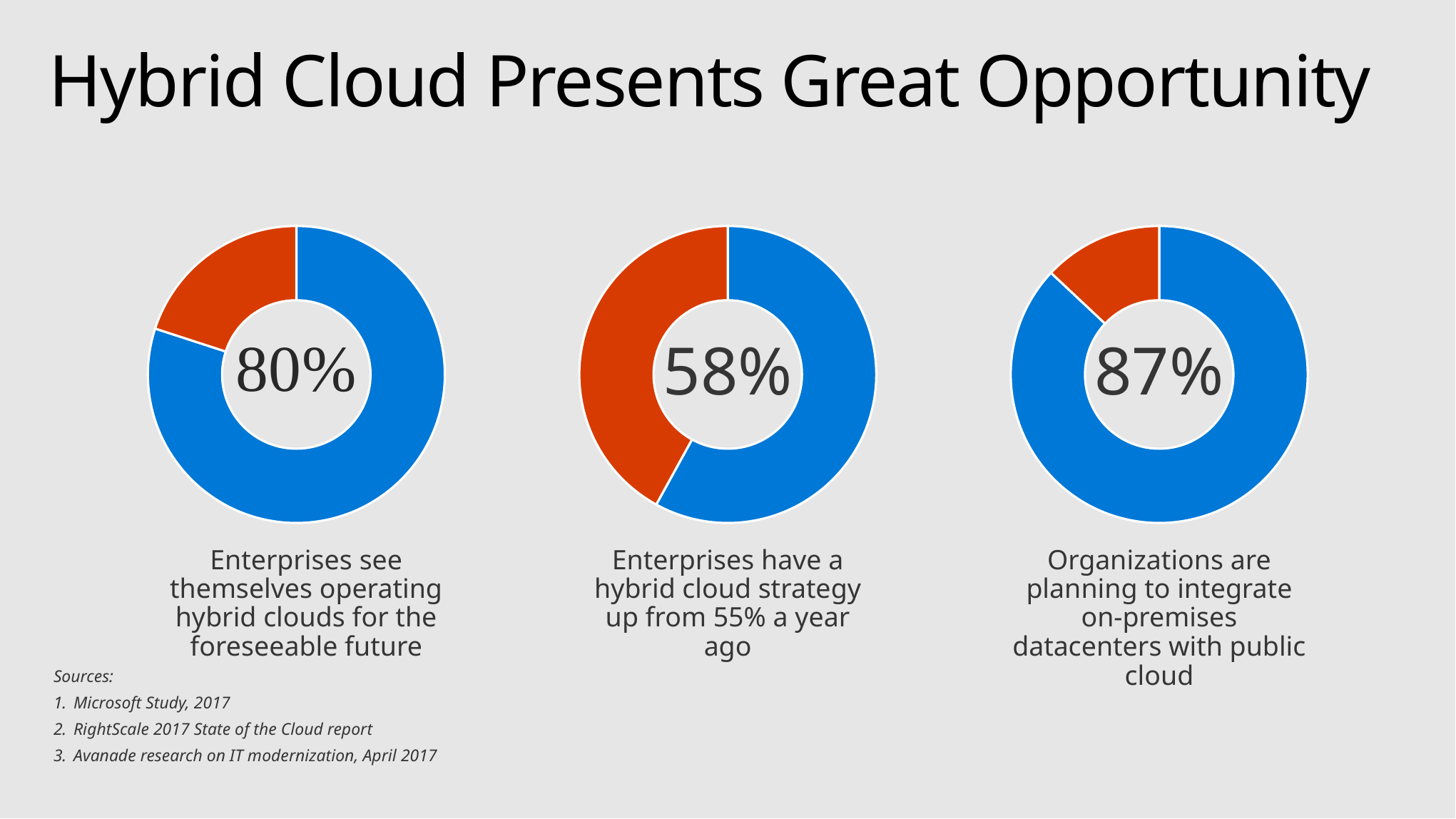
What is the difference between the percentage in the right donut chart and the percentage in the left donut chart? 7% What value is shown in the center of the left donut chart? 80% Which of the three donut charts shows the highest percentage? The right chart (87%) What is the difference between the percentage in the right donut chart and the percentage in the middle donut chart? 29% What value is shown in the center of the right donut chart? 87% Which colour represents the highlighted percentage in each donut chart? Blue How many donut charts are on the slide? 3 Is the percentage in the left donut chart larger or smaller than the percentage in the middle donut chart? Larger In the middle donut chart, what share of the ring is not blue (the orange portion)? 42% What value is shown in the center of the middle donut chart? 58% Which of the three donut charts shows the lowest percentage? The middle chart (58%) What kind of chart is used three times on this slide? Donut (pie) chart